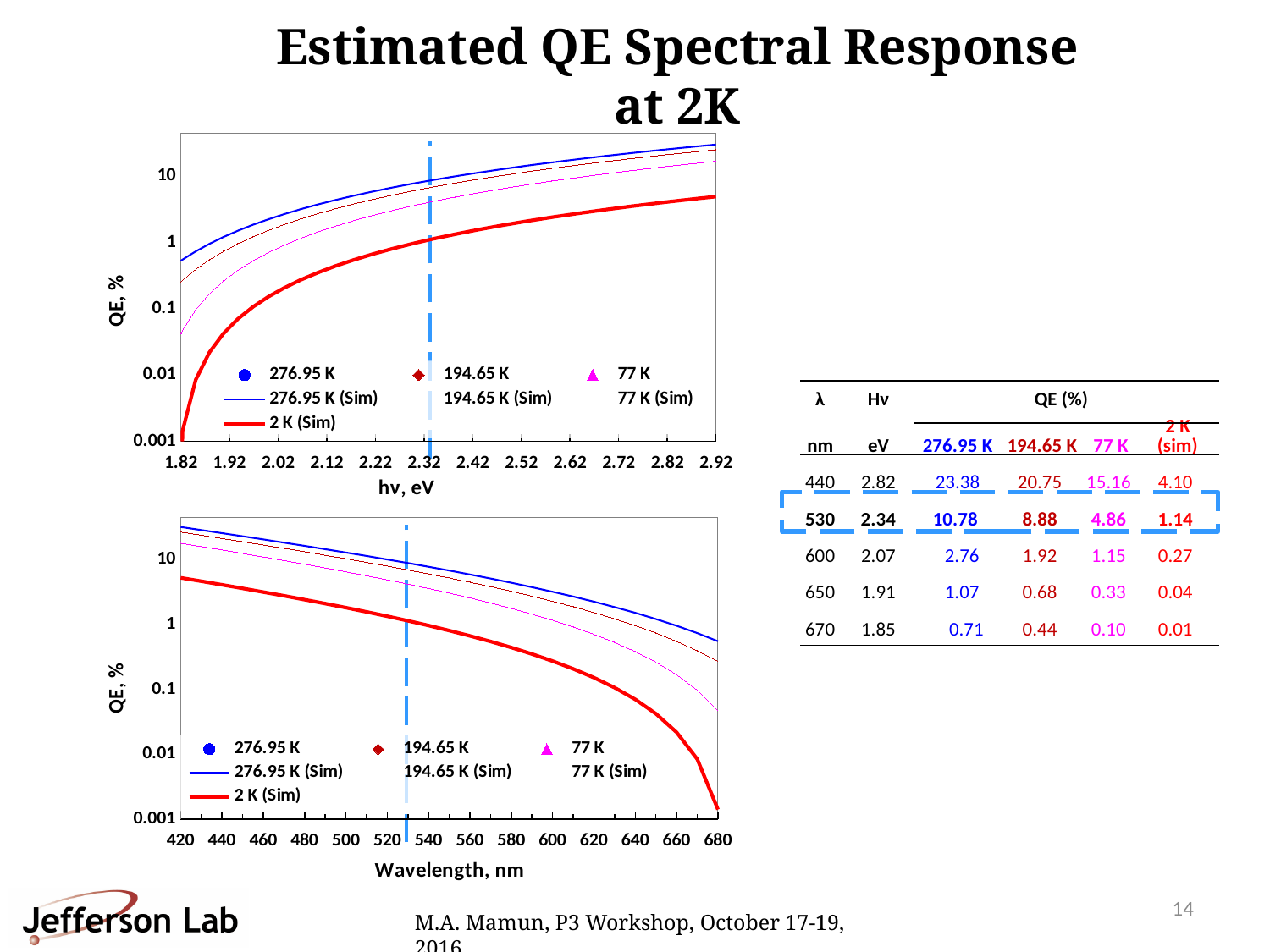
How many series does the legend of the top chart list? 7 In the bottom chart, is the value of the 276.95 K (Sim) curve at 420 nm greater or less than 10? greater In the top chart, which series has the lowest QE across the plotted range? 2 K (Sim) In the top chart, is the value of the 2 K (Sim) curve at 2.92 eV greater or less than 10? less In the top chart, is the value of the 276.95 K (Sim) curve at 2.92 eV greater or less than 10? greater In the bottom chart, which series has the highest QE across the plotted range? 276.95 K (Sim) In the bottom chart, do the QE values rise or fall as wavelength increases along the x axis? fall In the top chart, do the QE values rise or fall as hv increases along the x axis? rise What is the x-axis label of the bottom chart? Wavelength, nm What type of chart is the top chart on the slide? line chart